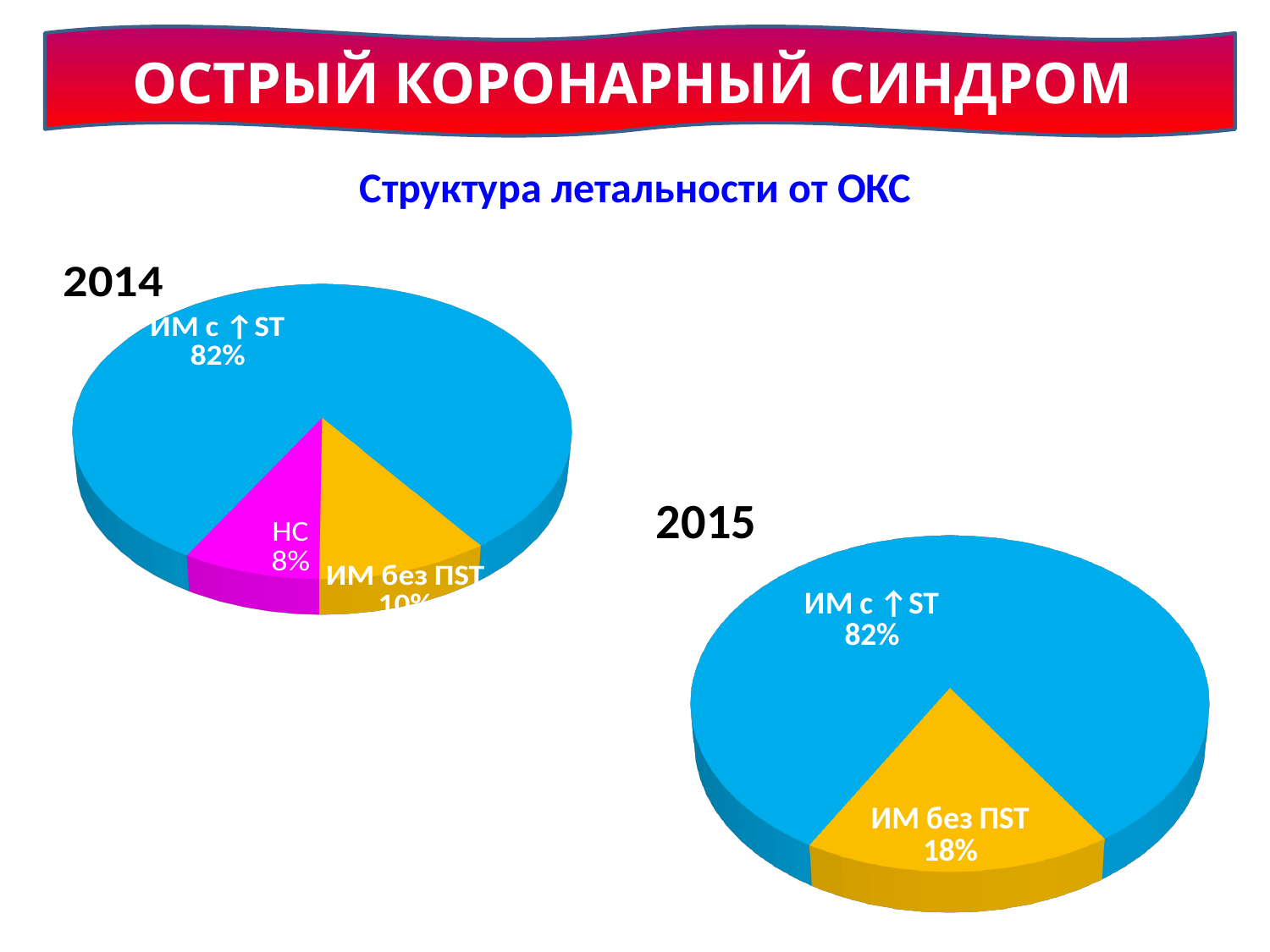
In the 2015 pie chart, which category has the smallest slice? ИМ без ПST In the 2014 pie chart, what share is labelled for ИМ с ↑ST? 82% How many slices does the 2015 pie chart have? 2 How many slices does the 2014 pie chart have? 3 In the 2014 pie chart, what share is labelled for НС? 8% What type of charts are shown on the slide? Pie charts In the 2015 pie chart, what share is labelled for ИМ без ПST? 18% In the 2014 pie chart, which category has the largest slice? ИМ с ↑ST In the 2014 pie chart, which category has the smallest slice? НС What is the subtitle above the two pie charts? Структура летальности от ОКС In the 2015 pie chart, what is the difference between the shares of ИМ с ↑ST and ИМ без ПST? 64%